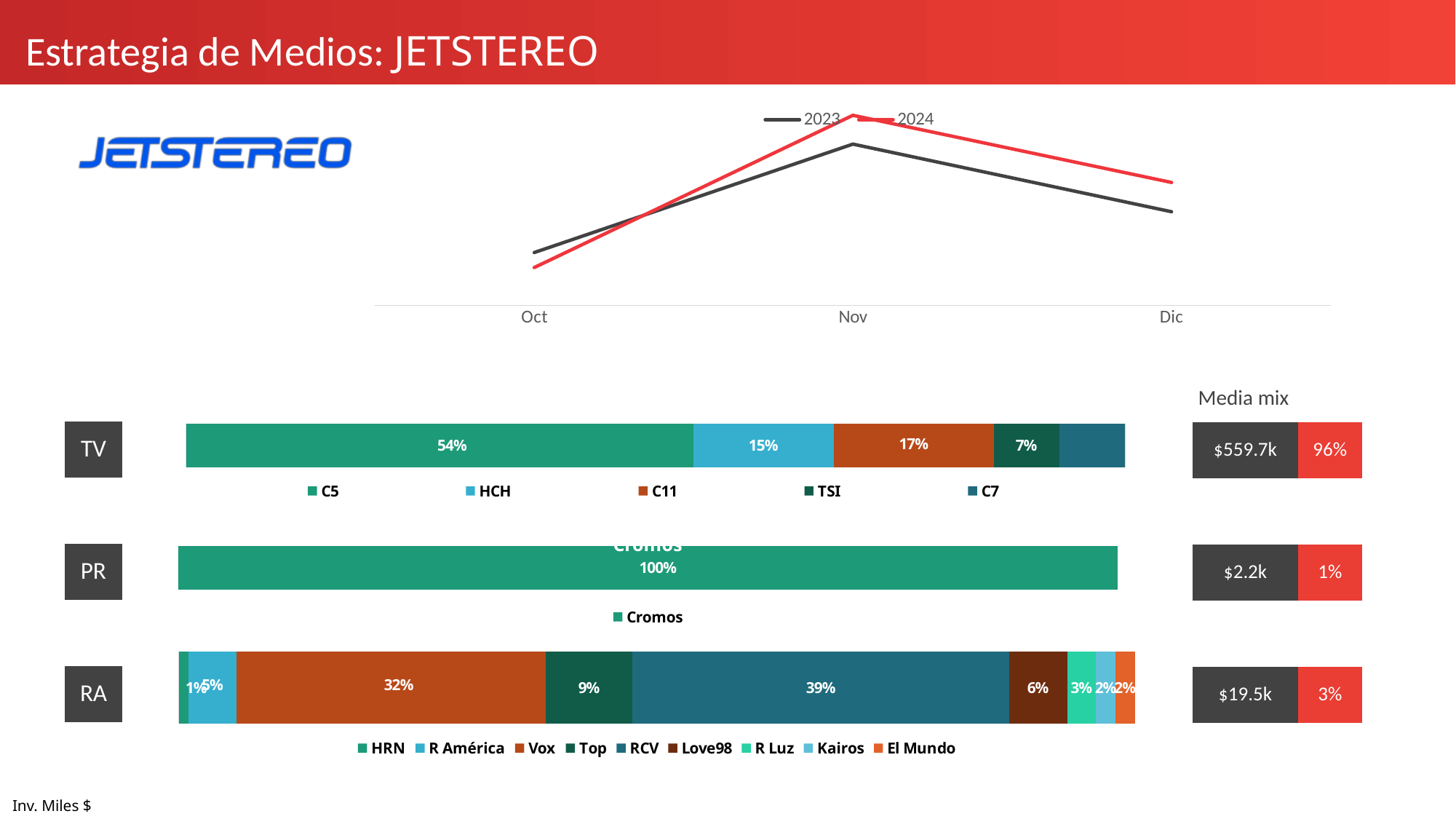
In the top line chart, is the 2024 value or the 2023 value larger in Dic? 2024 In the TV stacked bar, which channel has the largest share? C5 What kind of chart is the one at the top of the slide comparing 2023 and 2024 across Oct, Nov and Dic? line chart How many series does the legend of the top line chart list? 2 How many stations does the legend of the RA stacked bar list? 9 In the RA stacked bar, what share does RCV have? 39% How many months are plotted on the x axis of the top line chart? 3 In the RA stacked bar, which station has the smallest share? HRN In the TV stacked bar, what is the difference between the C11 share and the HCH share? 2% In the TV stacked bar, what share does C5 have? 54% In the top line chart, do the values rise or fall from Nov to Dic for the 2023 series? fall In the top line chart, which month has the highest value for the 2024 series? Nov